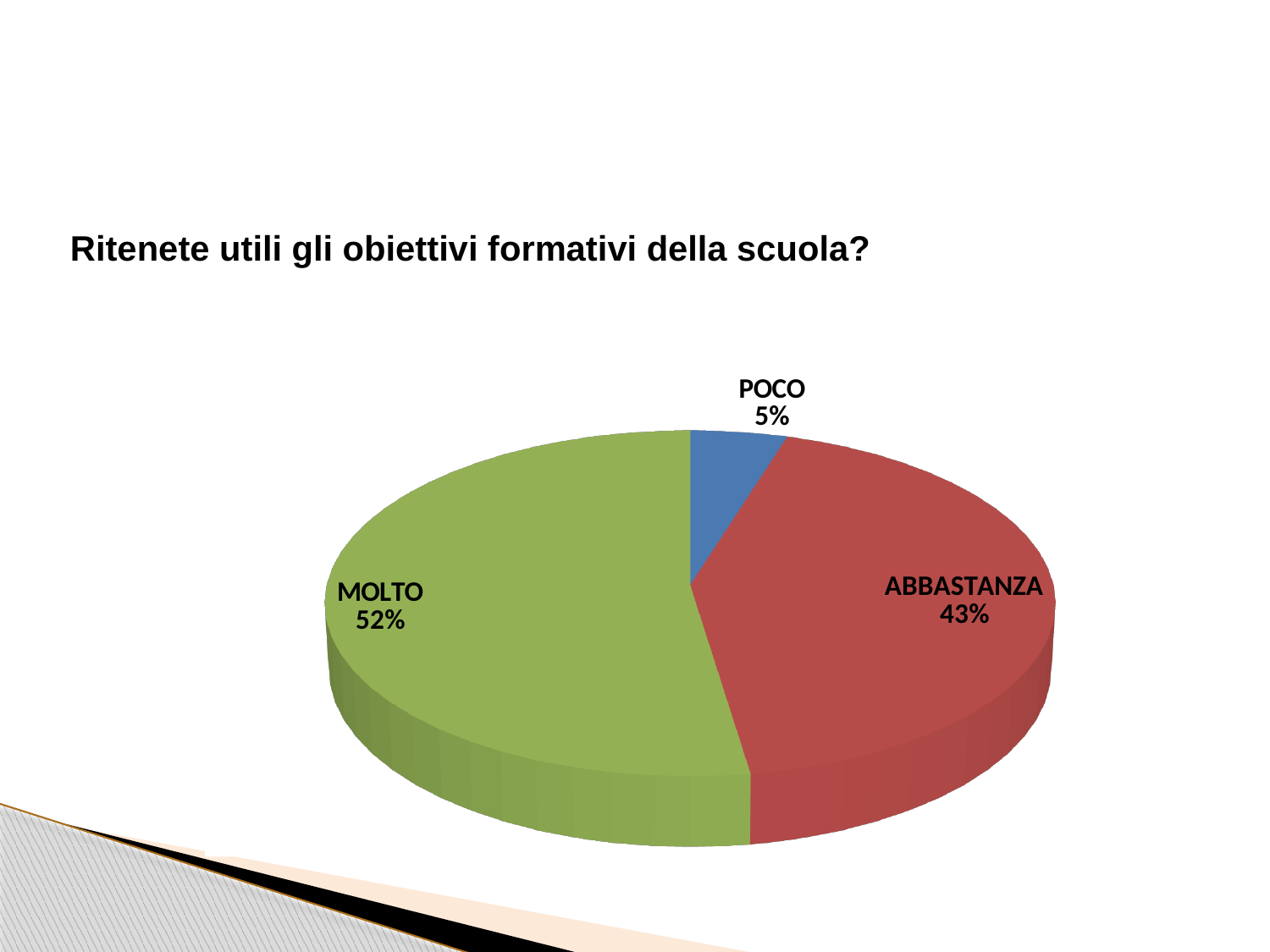
What is the difference in percentage points between MOLTO and ABBASTANZA? 9 What percentage of respondents answered ABBASTANZA? 43% What is the combined share of MOLTO and ABBASTANZA? 95% Which is larger, the share for MOLTO or the share for ABBASTANZA? MOLTO What kind of chart is shown on the slide? Pie chart What percentage of respondents answered POCO? 5% Which response has the largest share of the pie? MOLTO How many slices does the pie chart have? 3 What percentage of respondents answered MOLTO? 52% What is the difference in percentage points between ABBASTANZA and POCO? 38 What colour is the MOLTO slice? Green Which response has the smallest share of the pie? POCO